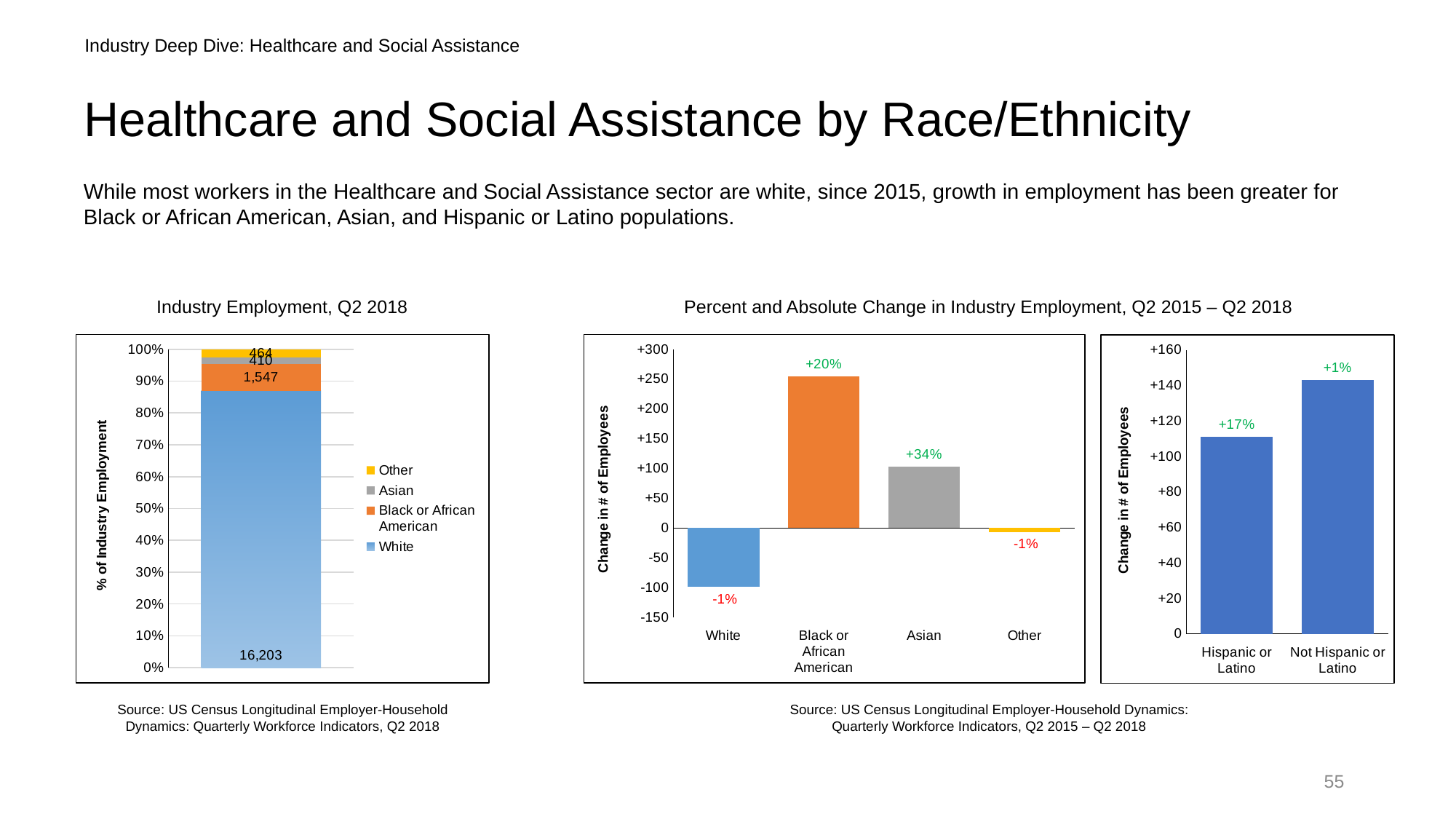
On the Industry Employment, Q2 2018 chart, what is the difference between the Black or African American value and the Asian value? 1,137 On the Industry Employment, Q2 2018 chart, what is the value shown for Black or African American? 1,547 On the Industry Employment, Q2 2018 chart, what is the value shown for Asian? 410 On the right-hand chart (change in employment for Hispanic or Latino vs Not Hispanic or Latino), is the change in number of employees for Not Hispanic or Latino greater or less than 120? greater On the middle chart (Percent and Absolute Change in Industry Employment by race), is the change in number of employees for Black or African American greater or less than 200? greater On the Industry Employment, Q2 2018 chart, what is the value shown for White? 16,203 On the Industry Employment, Q2 2018 chart, which group has the smallest value? Asian On the middle chart (Percent and Absolute Change in Industry Employment by race), what percent change is labelled for Asian? +34% On the middle chart (Percent and Absolute Change in Industry Employment by race), which group has the highest change in number of employees? Black or African American On the Industry Employment, Q2 2018 chart, what is the total of all four segments of the stacked bar? 18,624 On the right-hand chart (change in employment for Hispanic or Latino vs Not Hispanic or Latino), what percent change is labelled for Hispanic or Latino? +17% On the Industry Employment, Q2 2018 chart, how many series does the legend list? 4